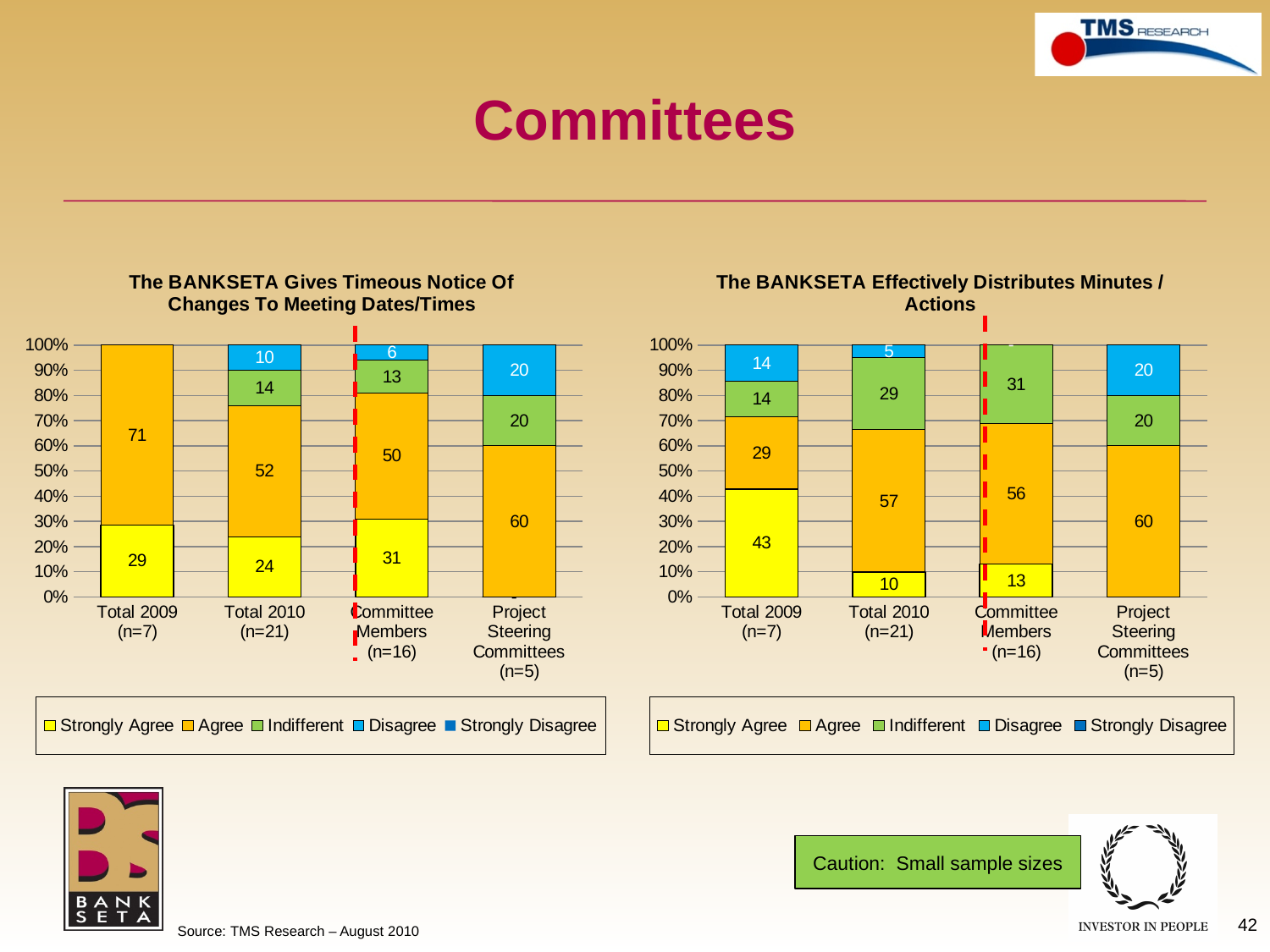
What kind of chart is 'The BANKSETA Gives Timeous Notice Of Changes To Meeting Dates/Times'? Stacked bar chart In the chart 'The BANKSETA Effectively Distributes Minutes / Actions', what is the Strongly Agree value for Total 2009 (n=7)? 43 In the chart 'The BANKSETA Gives Timeous Notice Of Changes To Meeting Dates/Times', what is the Disagree value for Project Steering Committees (n=5)? 20 In the chart 'The BANKSETA Gives Timeous Notice Of Changes To Meeting Dates/Times', what is the Strongly Agree value for Committee Members (n=16)? 31 In the chart 'The BANKSETA Effectively Distributes Minutes / Actions', which has the larger Indifferent value: Total 2010 (n=21) or Committee Members (n=16)? Committee Members (n=16) How many categories are shown on the x axis of the chart 'The BANKSETA Gives Timeous Notice Of Changes To Meeting Dates/Times'? 4 In the chart 'The BANKSETA Gives Timeous Notice Of Changes To Meeting Dates/Times', which category has the highest Agree value? Total 2009 (n=7) In the chart 'The BANKSETA Gives Timeous Notice Of Changes To Meeting Dates/Times', what is the Agree value for Total 2009 (n=7)? 71 In the chart 'The BANKSETA Effectively Distributes Minutes / Actions', what is the Disagree value for Total 2010 (n=21)? 5 In the chart 'The BANKSETA Effectively Distributes Minutes / Actions', which category has the highest Strongly Agree value? Total 2009 (n=7) In the chart 'The BANKSETA Gives Timeous Notice Of Changes To Meeting Dates/Times', what is the difference between the Agree value for Total 2009 (n=7) and the Agree value for Project Steering Committees (n=5)? 11 How many series does the legend of the chart 'The BANKSETA Effectively Distributes Minutes / Actions' list? 5